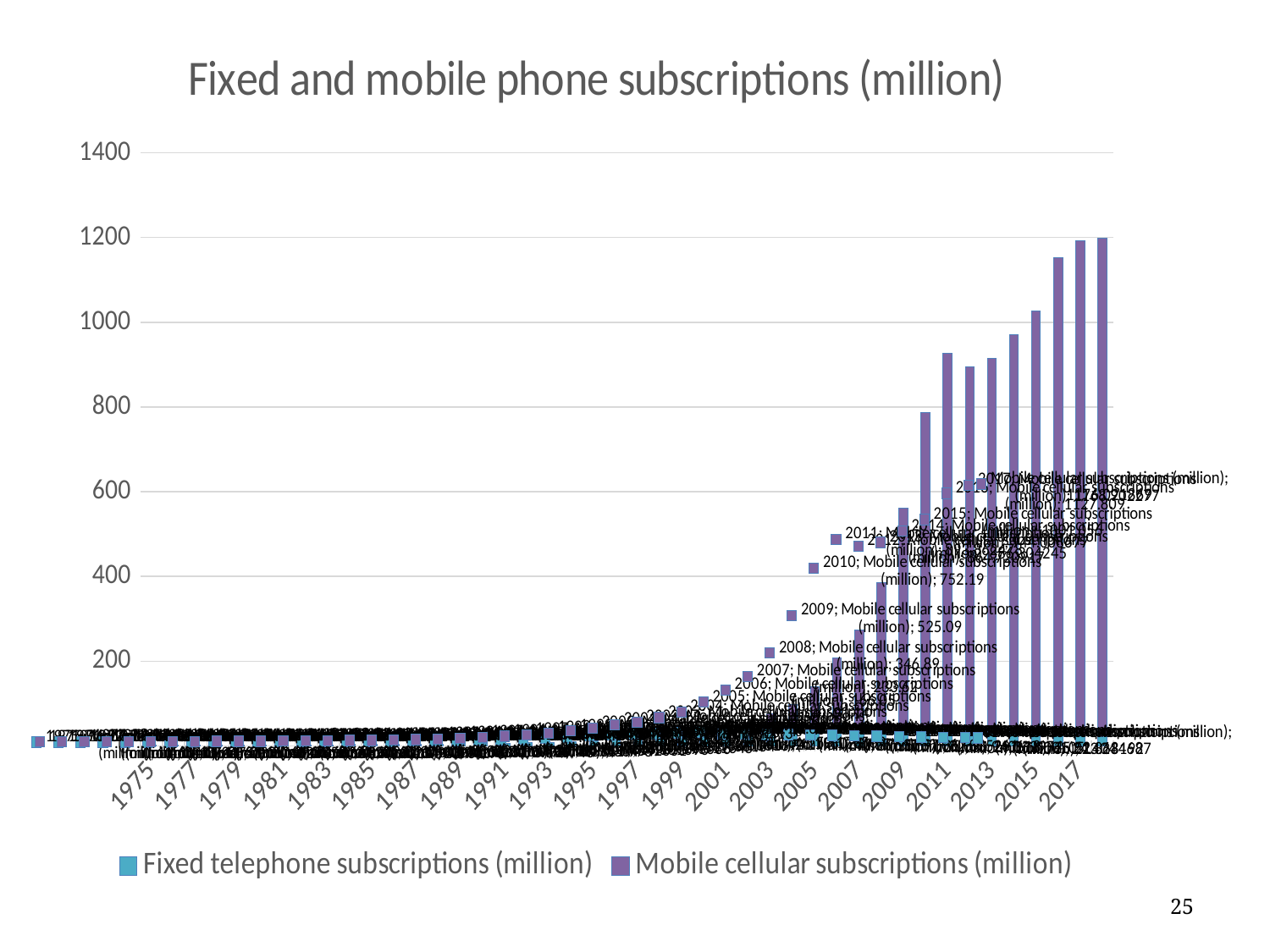
Do Mobile cellular subscriptions (million) generally rise or fall from 2005 to 2017? rise What is the value of Mobile cellular subscriptions (million) for 2010 according to its data label? 752.19 What is the value of Mobile cellular subscriptions (million) for 2009 according to its data label? 525.09 Is the value of the tallest Mobile cellular subscriptions bar greater or less than 1000? greater What are the two series named in the legend? Fixed telephone subscriptions (million) and Mobile cellular subscriptions (million) How many series does the legend list? 2 By how much did Mobile cellular subscriptions (million) increase from 2009 to 2010, using the data labels? 227.10 What is the title of the chart? Fixed and mobile phone subscriptions (million) Which series has the tallest bar on the chart? Mobile cellular subscriptions (million) Are all the Fixed telephone subscriptions (million) values greater or less than 200? less What is the value of Mobile cellular subscriptions (million) for 2008 according to its data label? 346.89 What kind of chart is shown on the slide? Bar chart